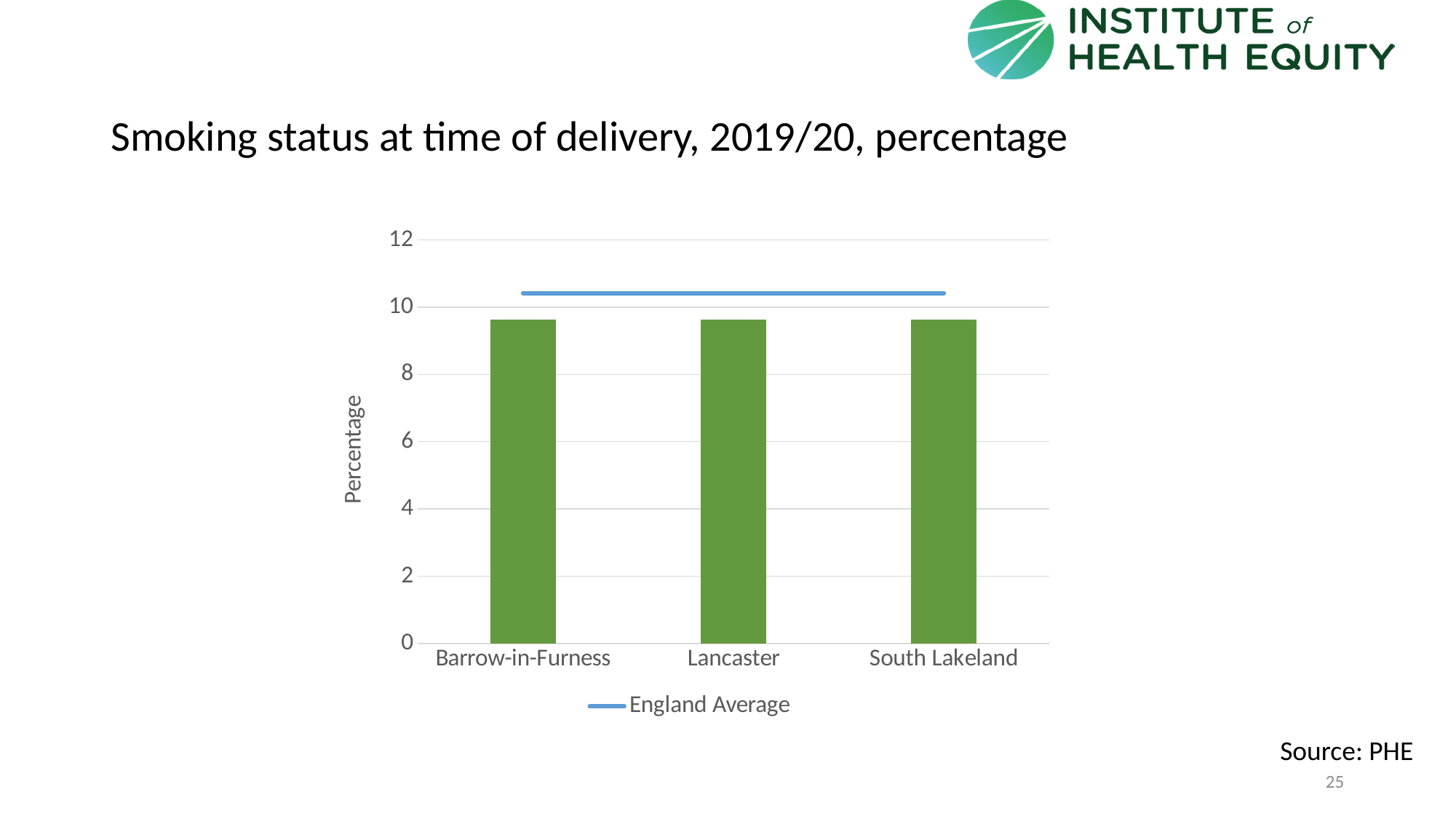
How many series does the chart's legend list? 1 Which is larger, the value for Lancaster or the England Average? England Average What kind of chart is shown on the slide? combination bar and line chart What is the title of the chart on the slide? Smoking status at time of delivery, 2019/20, percentage How many categories are shown on the x axis of the chart? 3 Is the value for Barrow-in-Furness greater or less than 10? less Is the England Average line greater or less than 10? greater Is the value for Lancaster greater or less than 10? less What series name is shown in the chart's legend? England Average Which is larger, the England Average or the value for Barrow-in-Furness? England Average